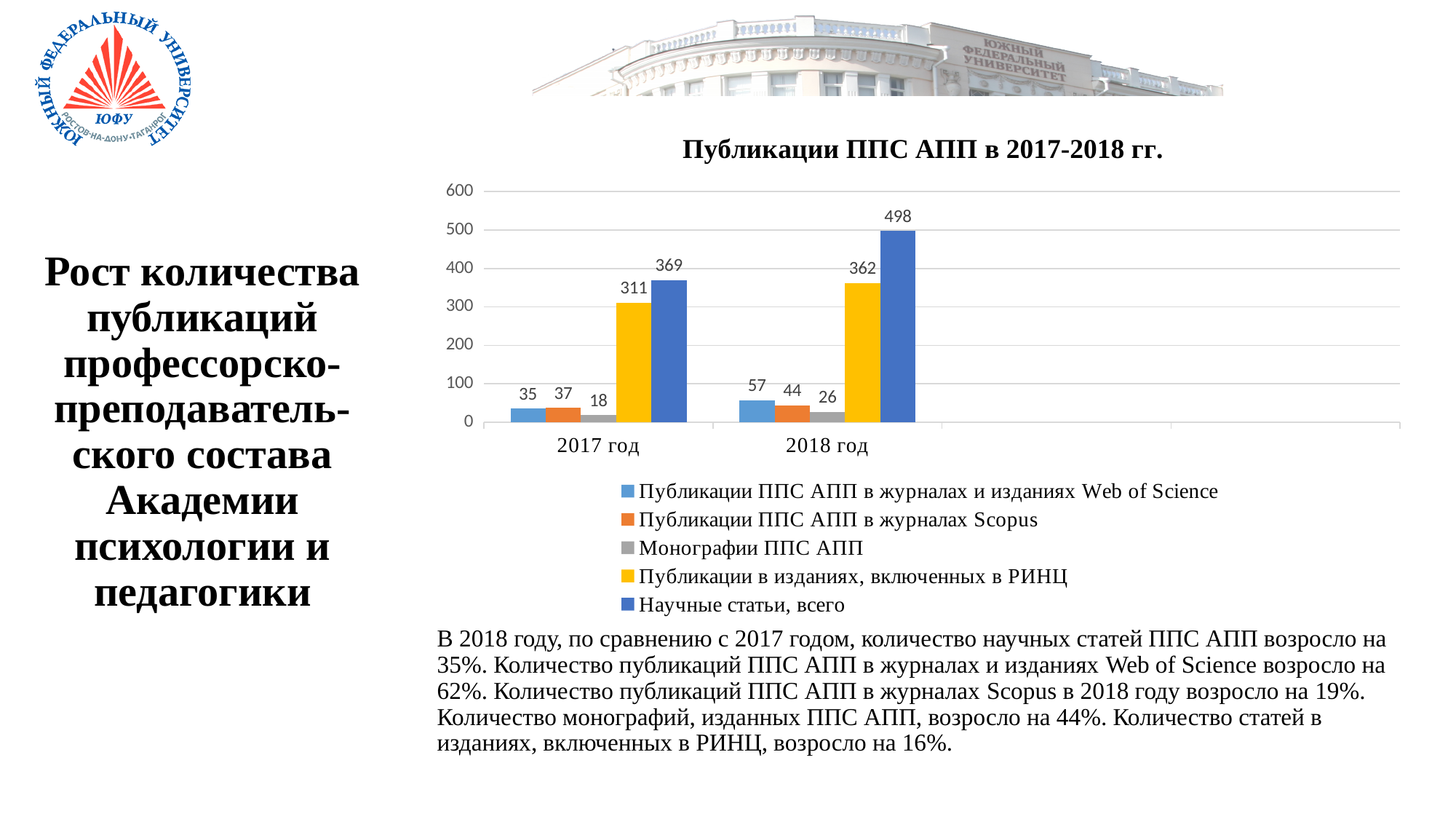
Which series has the lowest value in 2017 год? Монографии ППС АПП How many categories are shown on the x axis? 2 Which is larger: 'Публикации ППС АПП в журналах и изданиях Web of Science' in 2017 год or in 2018 год? 2018 год What kind of chart is shown on the slide? Bar chart Which series has the highest value in 2018 год? Научные статьи, всего What is the title of the chart? Публикации ППС АПП в 2017-2018 гг. What is the value for 'Научные статьи, всего' in 2018 год? 498 What is the difference between the 'Научные статьи, всего' values for 2018 год and 2017 год? 129 What is the value for 'Монографии ППС АПП' in 2018 год? 26 What is the value for 'Публикации ППС АПП в журналах Scopus' in 2017 год? 37 How many series does the legend list? 5 What is the value for 'Публикации в изданиях, включенных в РИНЦ' in 2017 год? 311